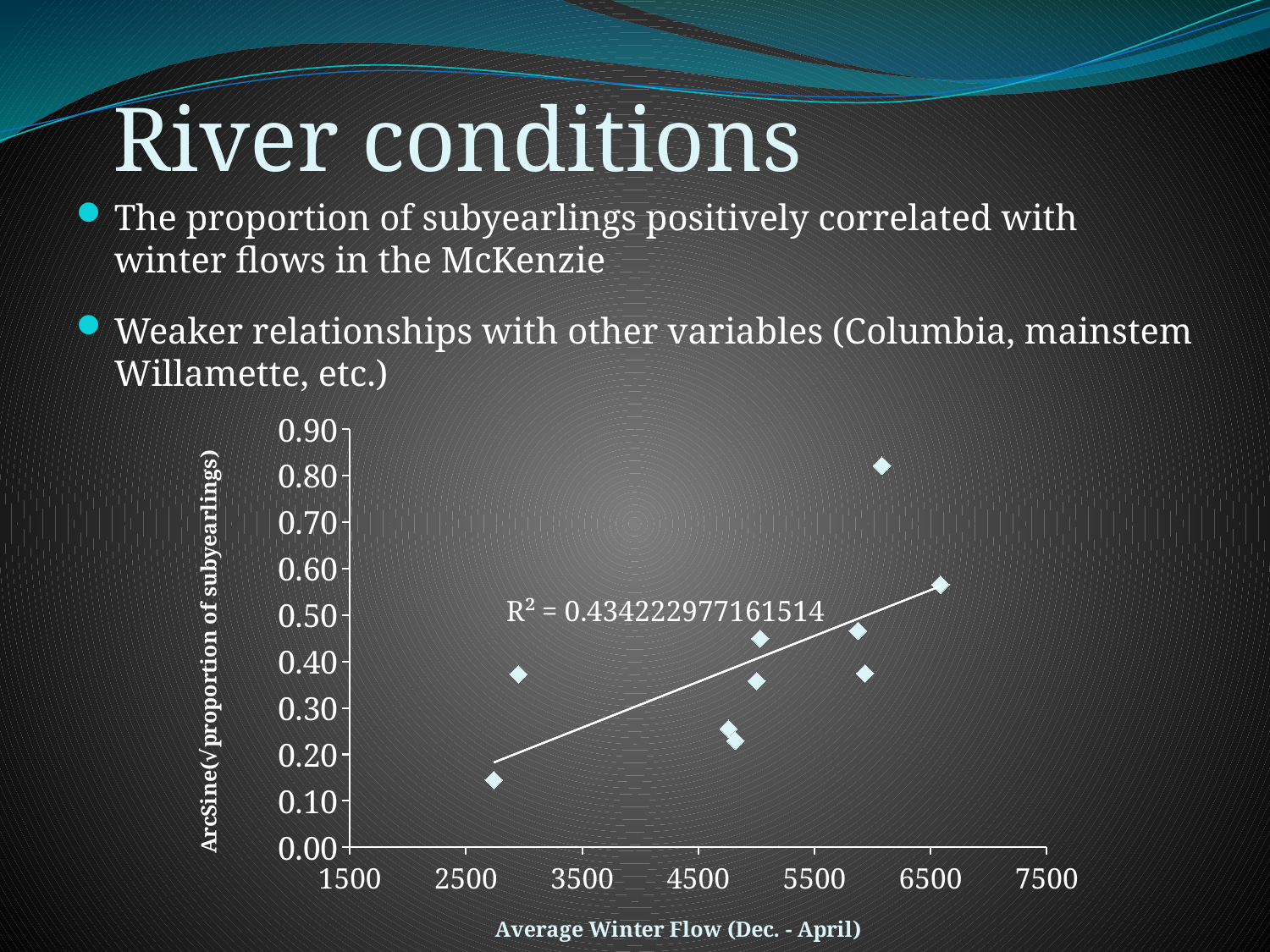
What kind of chart is shown on the slide? scatter chart Which has the higher y value: the point near 6050 on the x axis or the point near 6600 on the x axis? the point near 6050 Is the value of the point with the largest Average Winter Flow (near 6600) greater or less than 0.50? greater How many data points are plotted in the scatter chart? 10 What is the R² value printed on the chart? 0.434222977161514 What is the title of the x axis of the chart? Average Winter Flow (Dec. - April) Is the value of the highest plotted point greater or less than 0.80? greater Is the value of the point with the smallest Average Winter Flow (near 2750) greater or less than 0.30? less Do the plotted values generally rise or fall as Average Winter Flow increases along the x axis? rise What is the maximum value shown on the y axis of the chart? 0.90